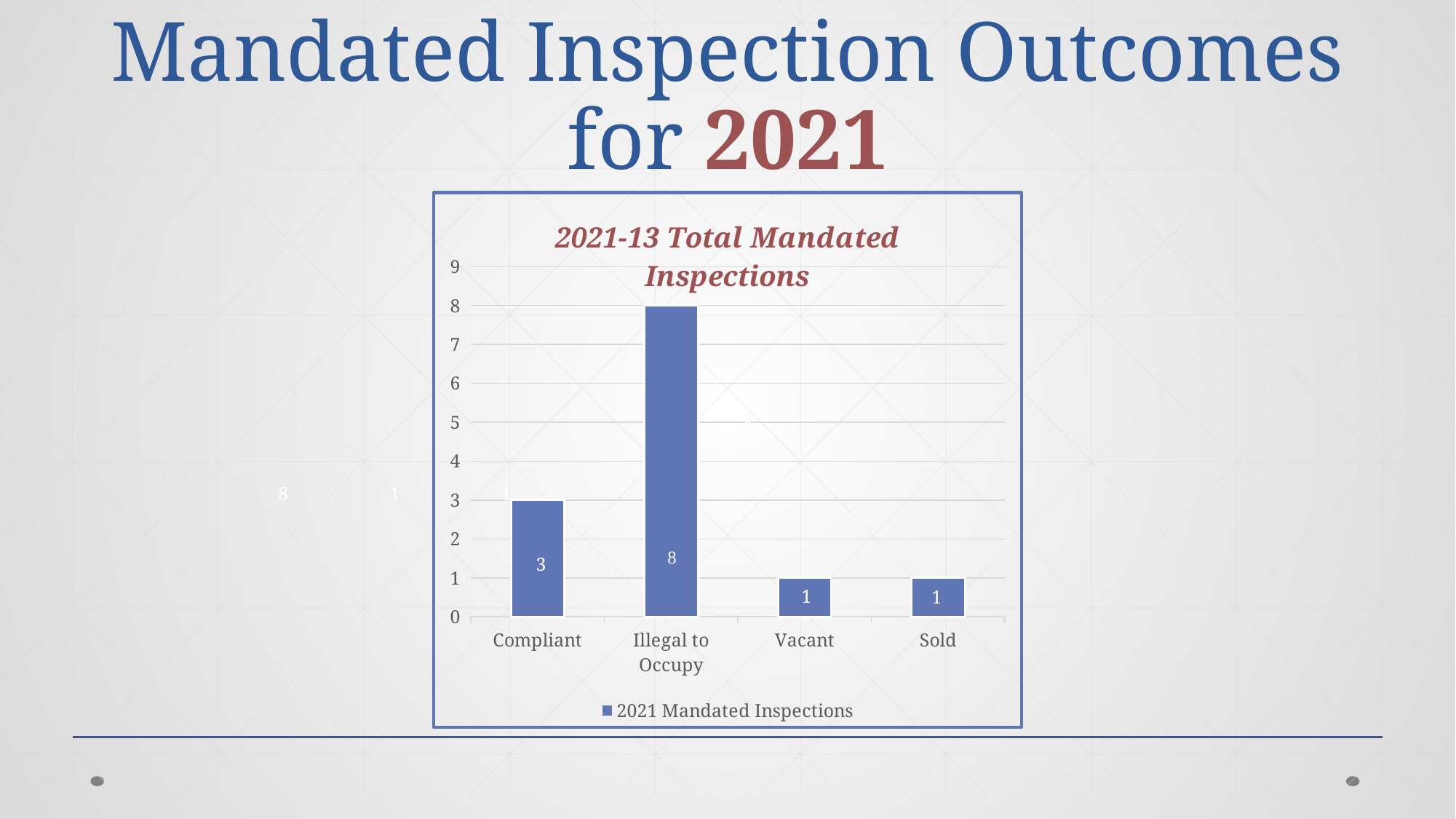
What is the value for Illegal to Occupy? 8 How many series does the legend list? 1 What is the title of the chart? 2021-13 Total Mandated Inspections Which is larger, the value for Compliant or the value for Vacant? Compliant What is the value for Sold? 1 What is the value for Compliant? 3 What is the value for Vacant? 1 How many categories are shown on the x axis? 4 What kind of chart is shown? bar chart Which category has the highest value? Illegal to Occupy Is the value for Illegal to Occupy greater or less than 5? greater What is the difference between the values for Illegal to Occupy and Compliant? 5